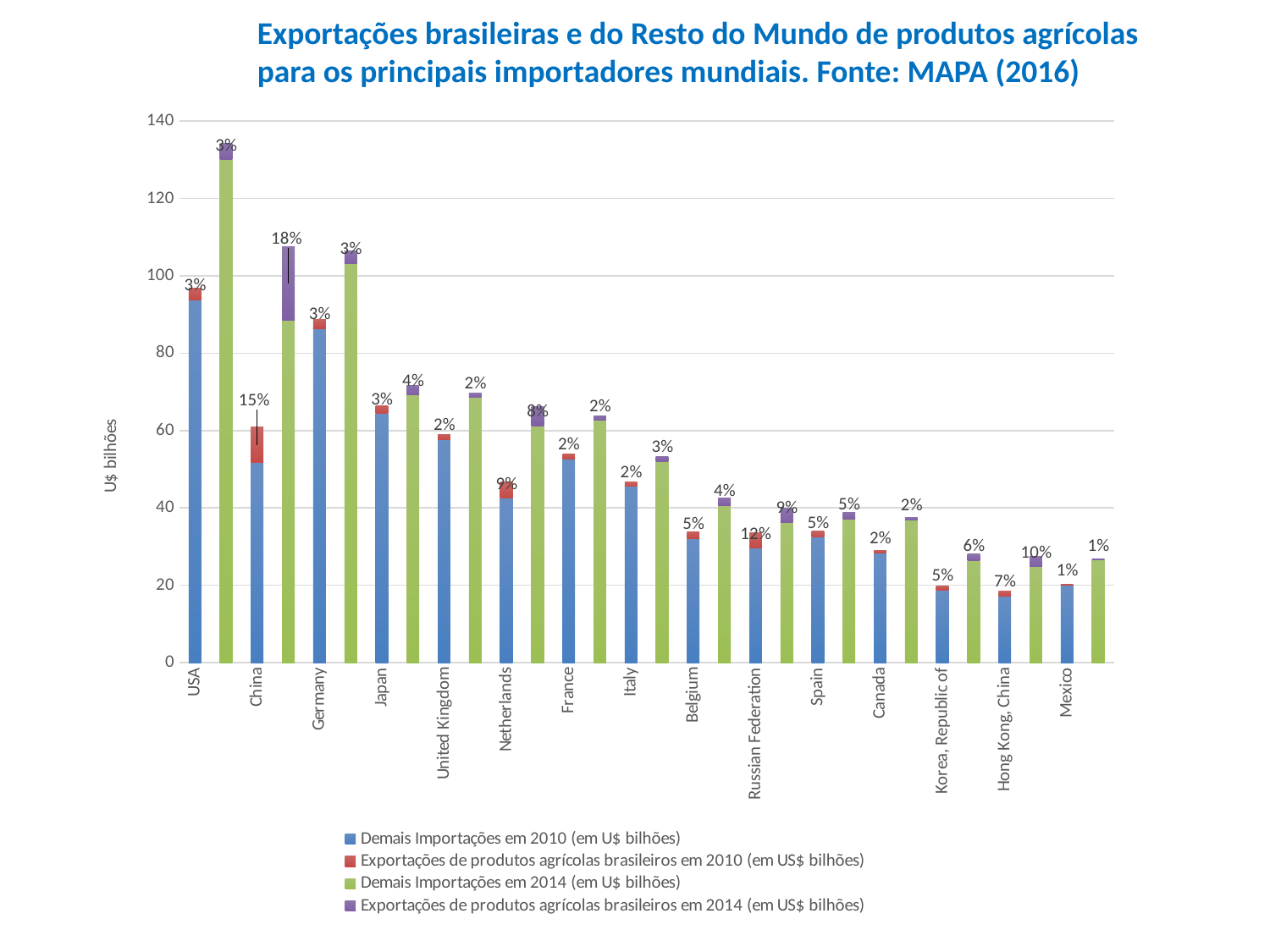
What percentage label is shown on the 2014 bar for Hong Kong, China? 10% What kind of chart is shown on the slide? Stacked bar chart What percentage label is shown on the 2010 bar for the Netherlands? 9% Which is larger, the 2014 bar for the USA or the 2014 bar for China? USA Do the bar heights generally rise or fall from left to right along the x axis? fall Which country has the tallest bar in the chart? USA What percentage label is shown on the 2014 bar for China? 18% What percentage label is shown on the 2010 bar for the Russian Federation? 12% Is the total of the 2014 bar for Mexico greater or less than 20? greater How many series does the legend list? 4 Is the total of the 2014 bar for the USA greater or less than 120? greater How many countries are shown on the x axis of the chart? 15